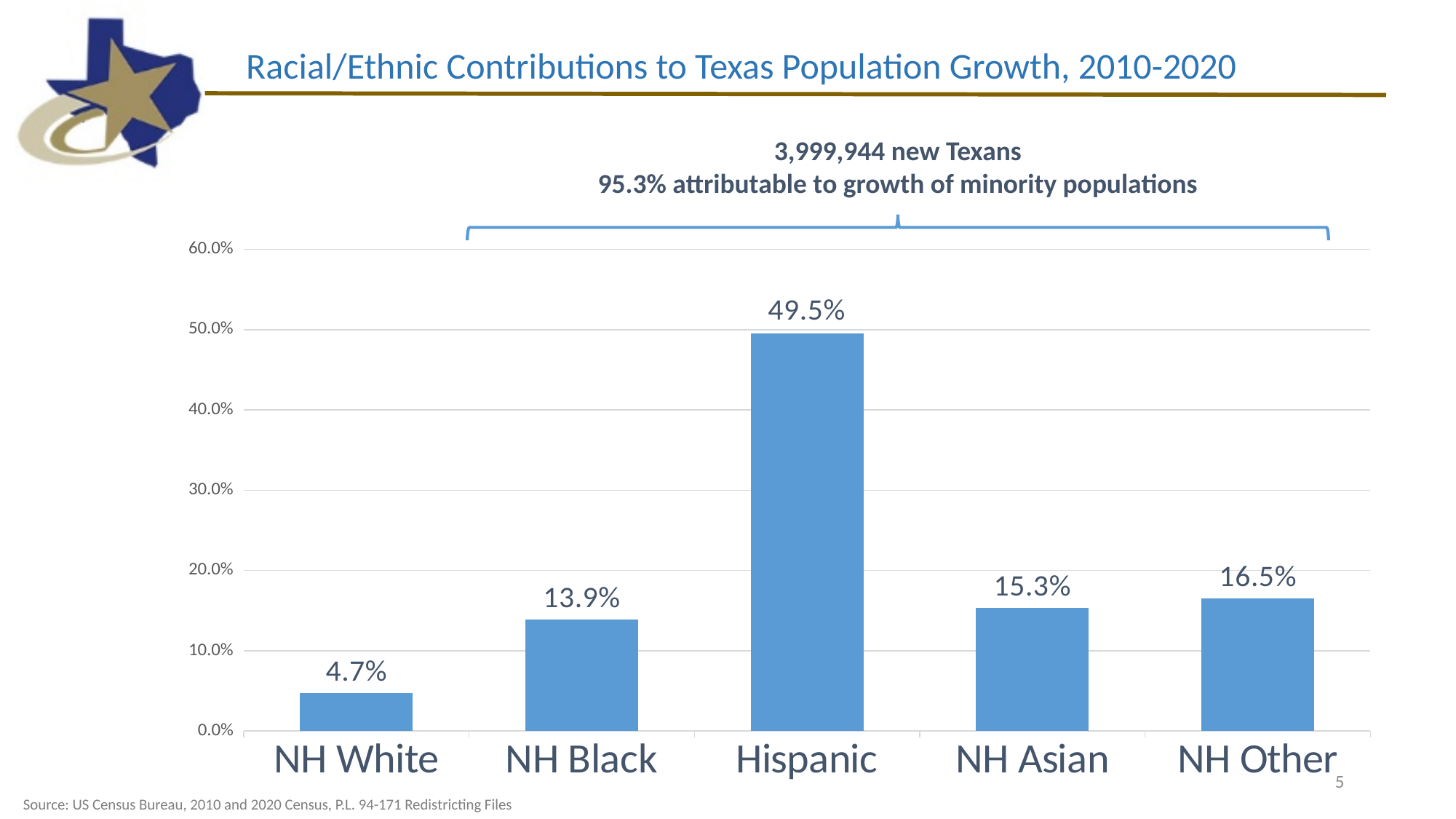
What is the value for Hispanic? 49.5% What is the value for NH Asian? 15.3% Which category has the highest value? Hispanic Which category has the lowest value? NH White Is the value for NH Asian greater or less than 20.0%? less Which is larger, the value for NH Other or the value for NH Black? NH Other What kind of chart is shown on the slide? bar chart What is the value for NH White? 4.7% How many categories are shown on the x axis? 5 What is the title of the chart? Racial/Ethnic Contributions to Texas Population Growth, 2010-2020 What is the difference between the values for Hispanic and NH Black? 35.6% What is the difference between the values for NH Other and NH White? 11.8%